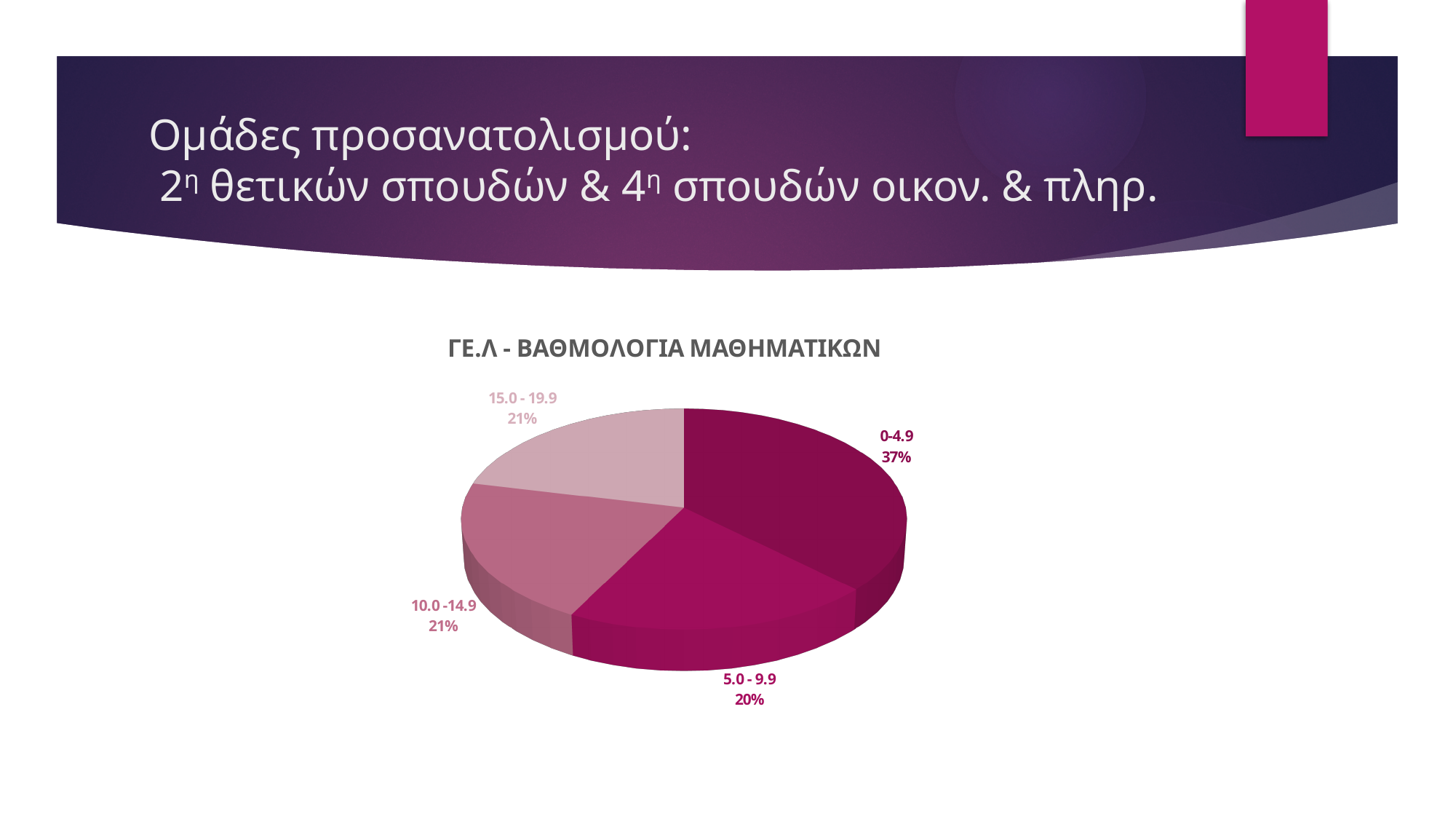
What is the title of the chart? ΓΕ.Λ - ΒΑΘΜΟΛΟΓΙΑ ΜΑΘΗΜΑΤΙΚΩΝ What is the combined share of the 10.0 -14.9 and 15.0 - 19.9 slices? 42% Which category has the smallest share of the pie? 5.0 - 9.9 What percentage is shown for the 10.0 -14.9 slice? 21% Which category has the largest share of the pie? 0-4.9 What percentage is shown for the 15.0 - 19.9 slice? 21% How many slices does the pie chart have? 4 Which is larger, the share for 0-4.9 or the share for 15.0 - 19.9? 0-4.9 What percentage is shown for the 5.0 - 9.9 slice? 20% What kind of chart is shown on the slide? Pie chart What share of the pie does the 0-4.9 category have? 37% What is the difference in percentage points between the 0-4.9 slice and the 5.0 - 9.9 slice? 17